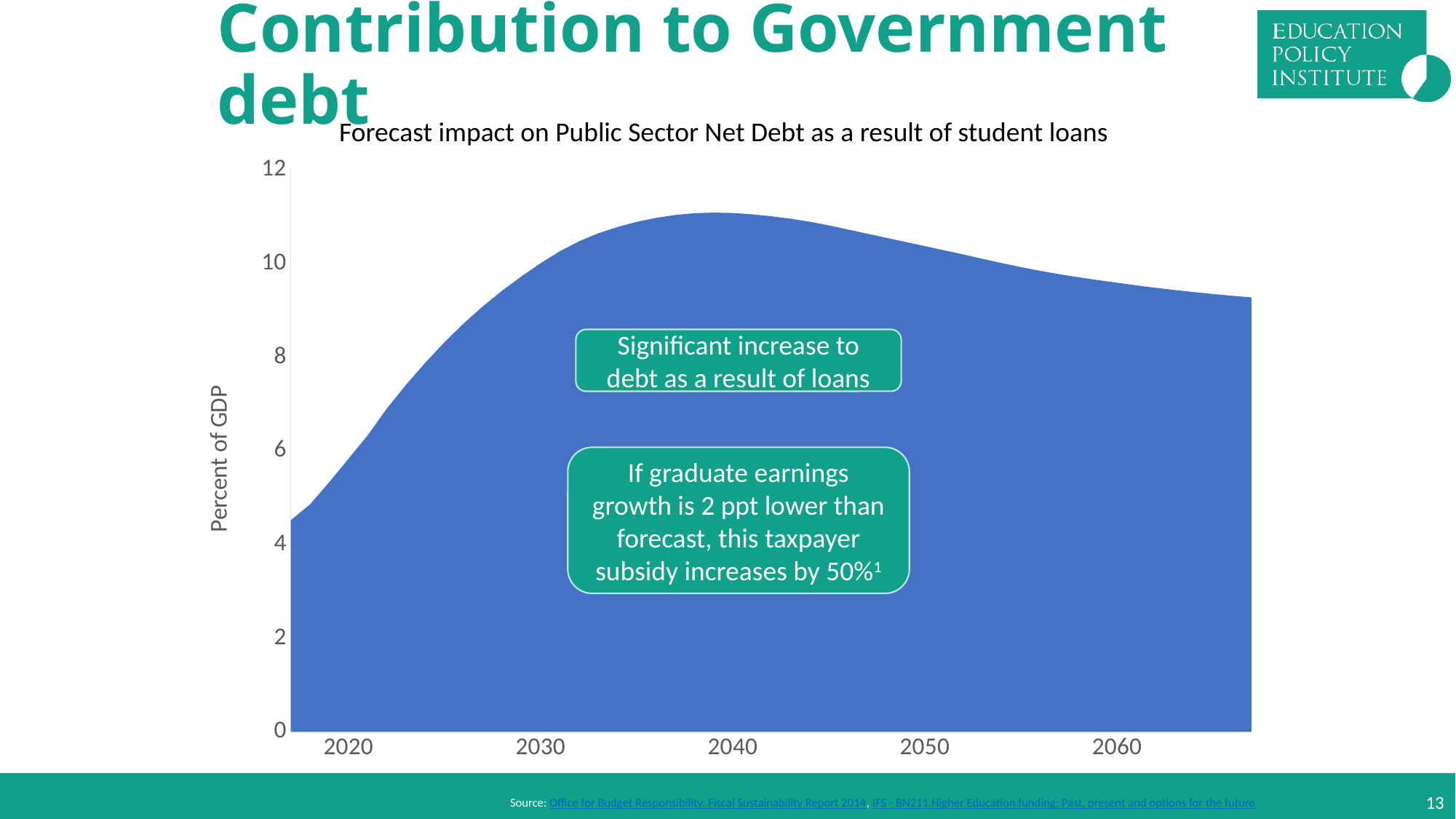
Is the value for 2030 greater or less than 8? greater Is the value for 2020 greater or less than 4? greater What is the title of the chart? Forecast impact on Public Sector Net Debt as a result of student loans What type of chart is shown on the slide? area chart Which is larger, the value for 2020 or the value for 2040? 2040 How many year labels are shown on the horizontal axis? 5 Is the value for 2060 greater or less than 10? less What is the label on the vertical axis of the chart? Percent of GDP Does the value rise or fall between 2020 and 2030? rise Does the value rise or fall between 2040 and 2060? fall